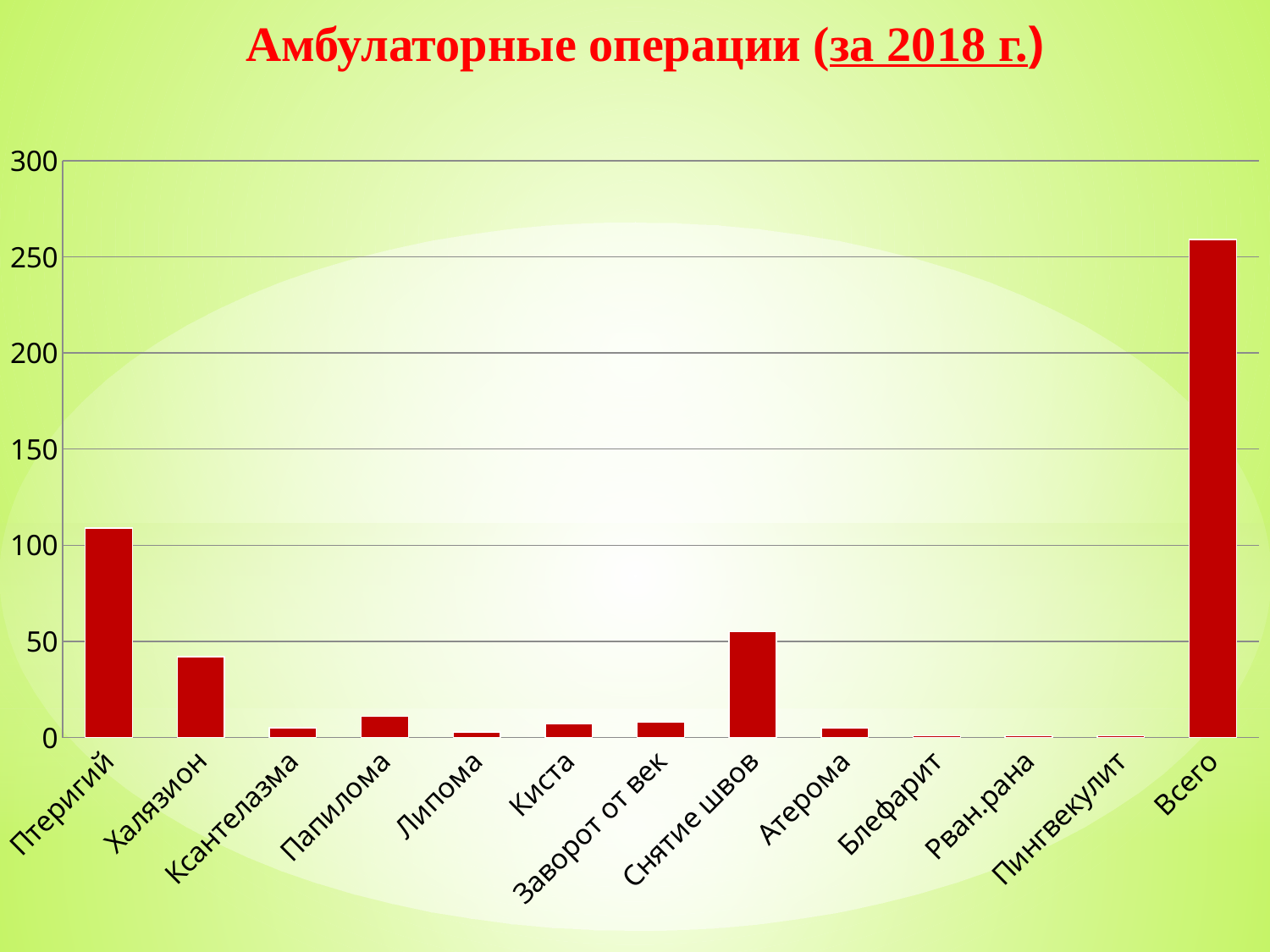
Is the value for Халязион greater or less than 50? less Is the value for Птеригий greater or less than 100? greater What kind of chart is shown on the slide? bar chart Is the value for Всего greater or less than 250? greater Which is larger, the value for Снятие швов or the value for Халязион? Снятие швов What is the title of the chart on the slide? Амбулаторные операции (за 2018 г.) What colour are the bars in the chart? red Which is larger, the value for Папилома or the value for Липома? Папилома Which category has the highest bar in the chart? Всего Which is larger, the value for Птеригий or the value for Халязион? Птеригий How many categories are shown on the x axis of the chart? 13